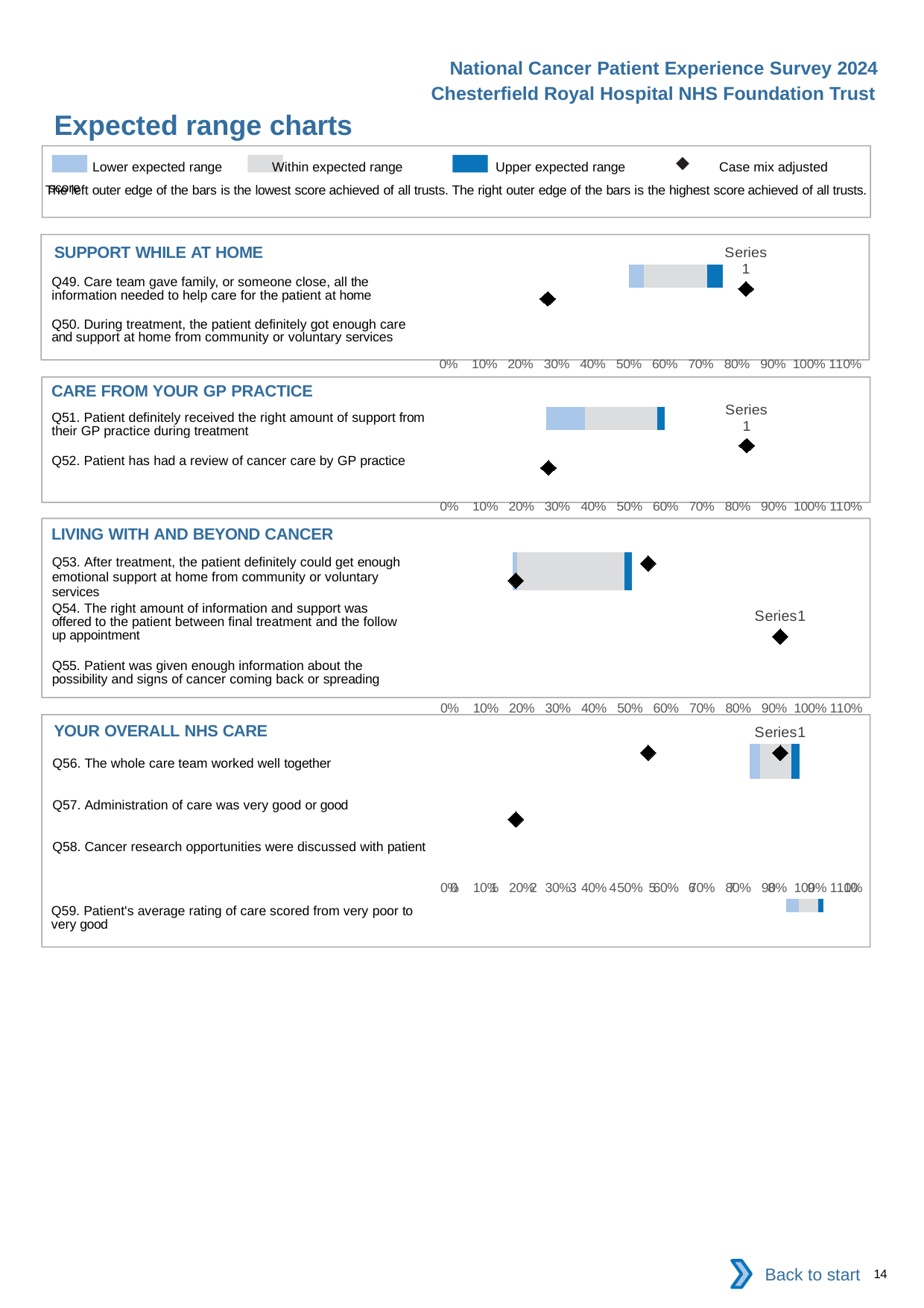
How many questions are listed in the SUPPORT WHILE AT HOME chart? 2 In the SUPPORT WHILE AT HOME chart, is the highest plotted case mix adjusted score greater or less than 70%? greater According to the legend, what does the black diamond marker represent? Case mix adjusted score In the YOUR OVERALL NHS CARE chart, is the lowest plotted case mix adjusted score greater or less than 30%? less In the SUPPORT WHILE AT HOME chart, is the lowest plotted case mix adjusted score greater or less than 40%? less How many questions are listed in the LIVING WITH AND BEYOND CANCER chart? 3 How many case mix adjusted score diamonds are plotted in the LIVING WITH AND BEYOND CANCER chart? 3 What is the highest tick label shown on the x axis of the charts? 110% How many entries does the legend at the top of the slide list? 4 What kind of chart is used in the Expected range charts on this slide? bar chart